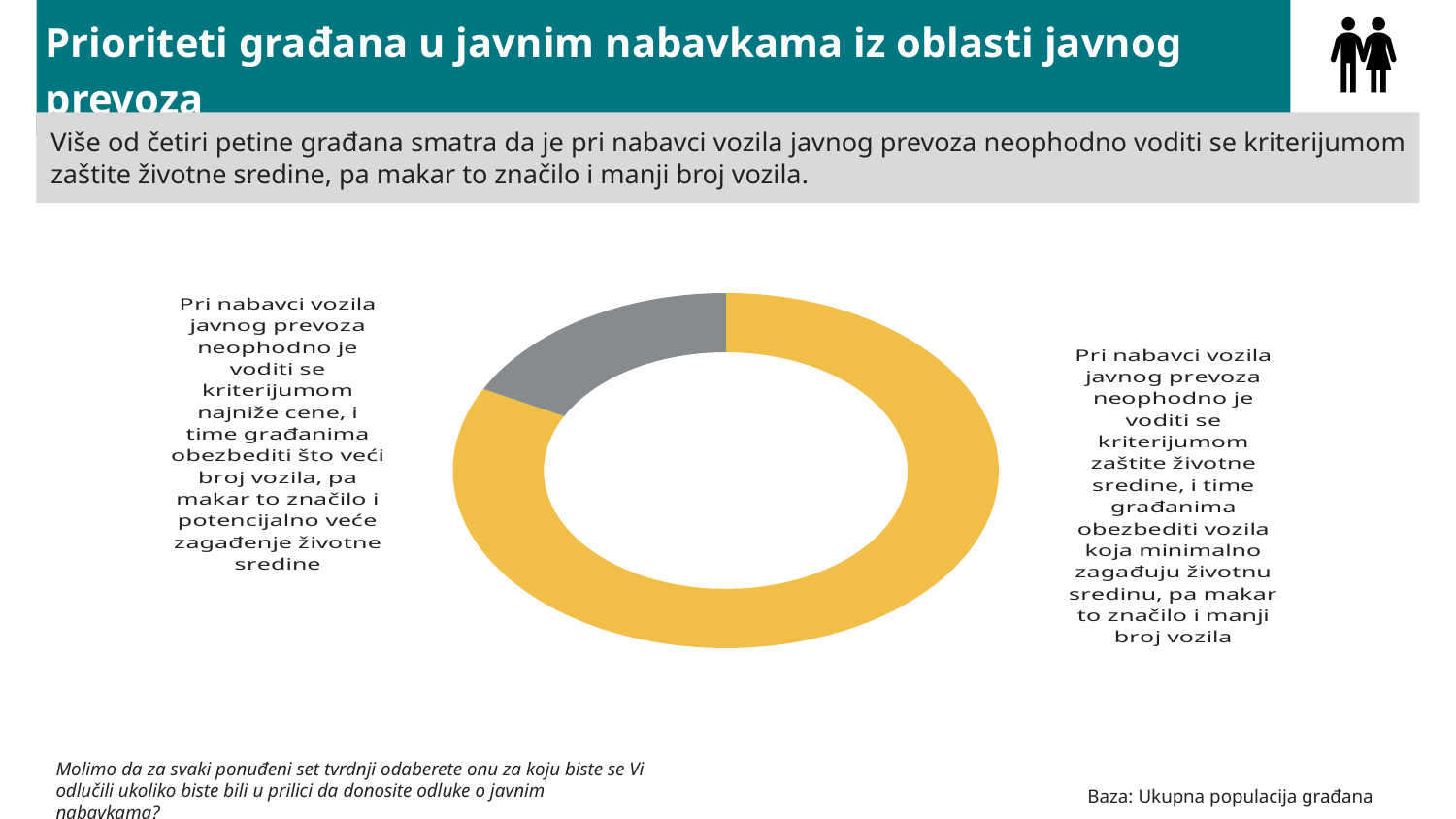
Which option has the smallest share of the donut chart? Pri nabavci vozila javnog prevoza neophodno je voditi se kriterijumom najniže cene How many slices does the donut chart have? 2 What is the base (Baza) of the survey shown on the slide? Ukupna populacija građana What colour is the slice representing the environmental-protection criterion (zaštite životne sredine)? Yellow Which option has the largest share of the donut chart? Pri nabavci vozila javnog prevoza neophodno je voditi se kriterijumom zaštite životne sredine Which option has the larger share of the donut chart: the lowest-price criterion (najniže cene) or the environmental-protection criterion (zaštite životne sredine)? Zaštite životne sredine (environmental protection) Is the share of the environmental-protection criterion (zaštite životne sredine) greater or less than 50%? greater What colour is the slice representing the lowest-price criterion (najniže cene)? Gray Is the share of the lowest-price criterion (najniže cene) greater or less than 50%? less What kind of chart is shown on the slide? Pie chart (donut)